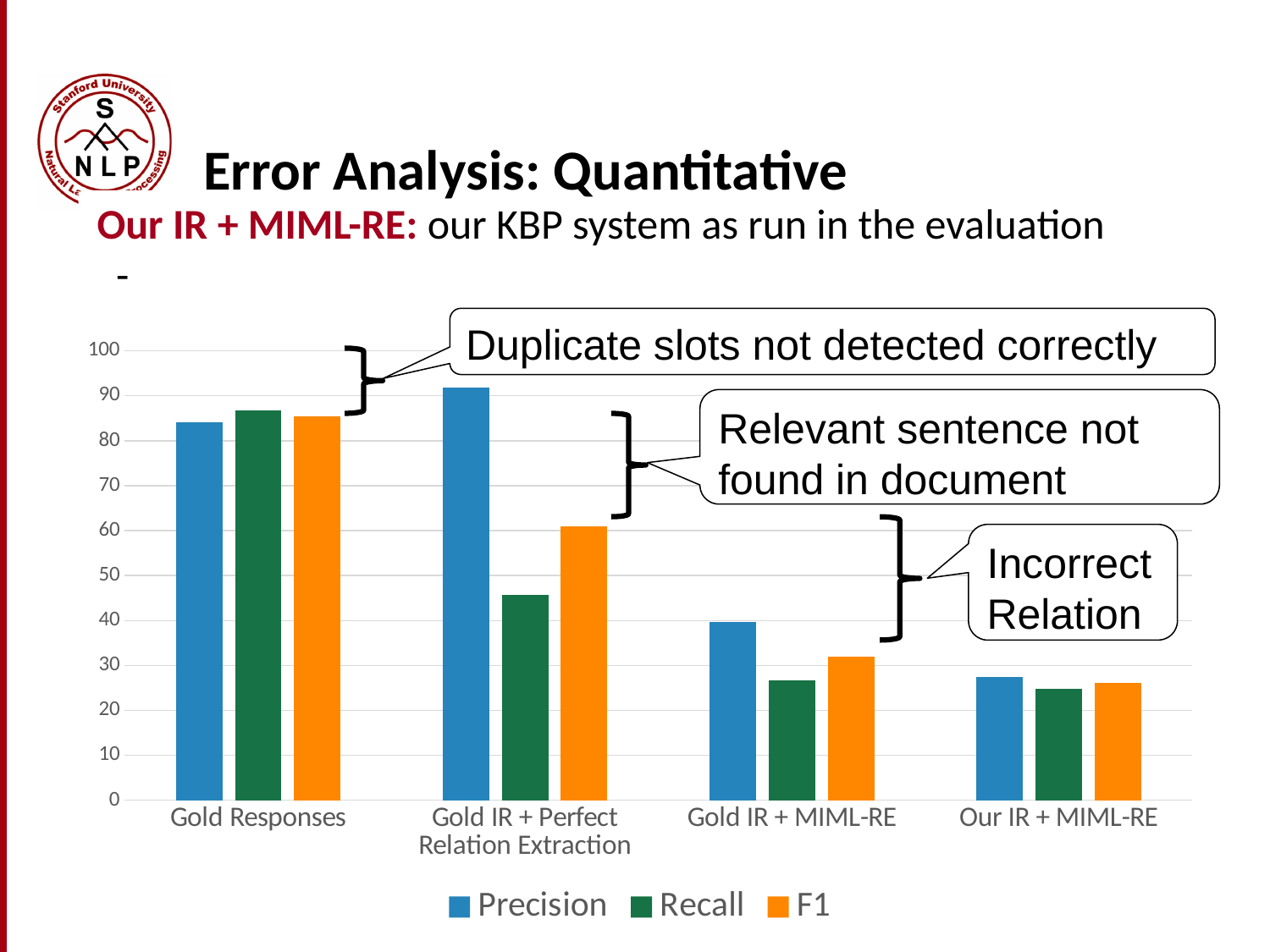
For Gold IR + MIML-RE, which is larger: Precision or Recall? Precision Do the F1 values rise or fall moving left to right across the categories? fall How many categories are shown on the x axis? 4 What kind of chart is shown on the slide? bar chart Is the Precision value for Gold IR + Perfect Relation Extraction greater or less than 80? greater Which category has the lowest F1 bar? Our IR + MIML-RE Is the F1 value for Gold Responses greater or less than 80? greater How many series does the legend list? 3 Which has the larger Recall value: Gold Responses or Gold IR + Perfect Relation Extraction? Gold Responses Is the Recall value for Gold IR + Perfect Relation Extraction greater or less than 50? less Which category has the highest Precision bar? Gold IR + Perfect Relation Extraction What are the three series listed in the legend? Precision, Recall, F1